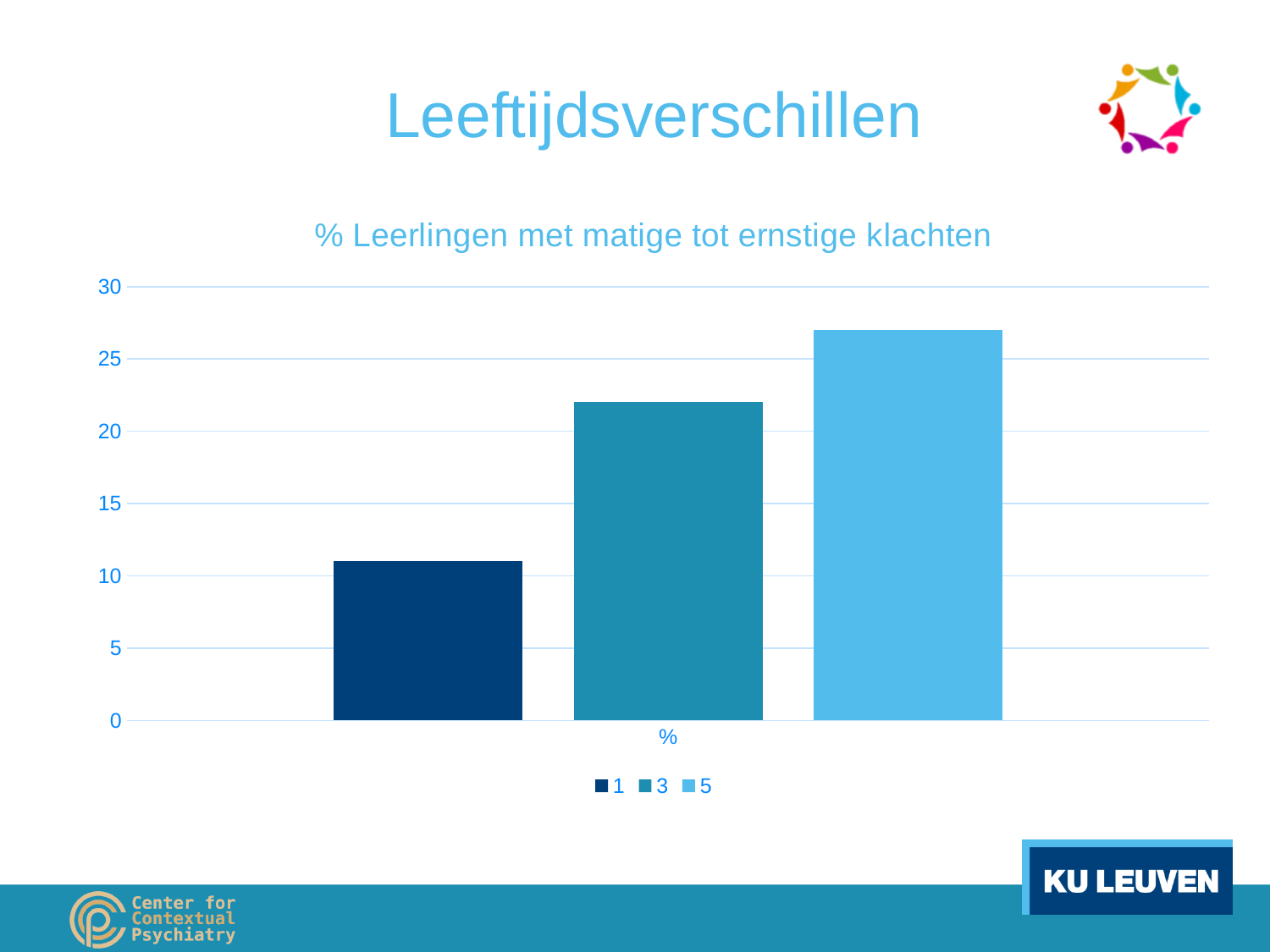
What are the series names listed in the legend? 1, 3, 5 What kind of chart is shown on the slide? bar chart Which is larger, the bar for series 3 or the bar for series 1? 3 How many categories are shown on the x axis? 1 Is the value for series 5 greater or less than 25? greater Do the bars rise or fall from series 1 to series 5? rise Is the value for series 3 greater or less than 20? greater Which series has the lowest bar? 1 What is the title of the chart? % Leerlingen met matige tot ernstige klachten How many series does the legend list? 3 Which series has the highest bar? 5 Is the value for series 1 greater or less than 15? less